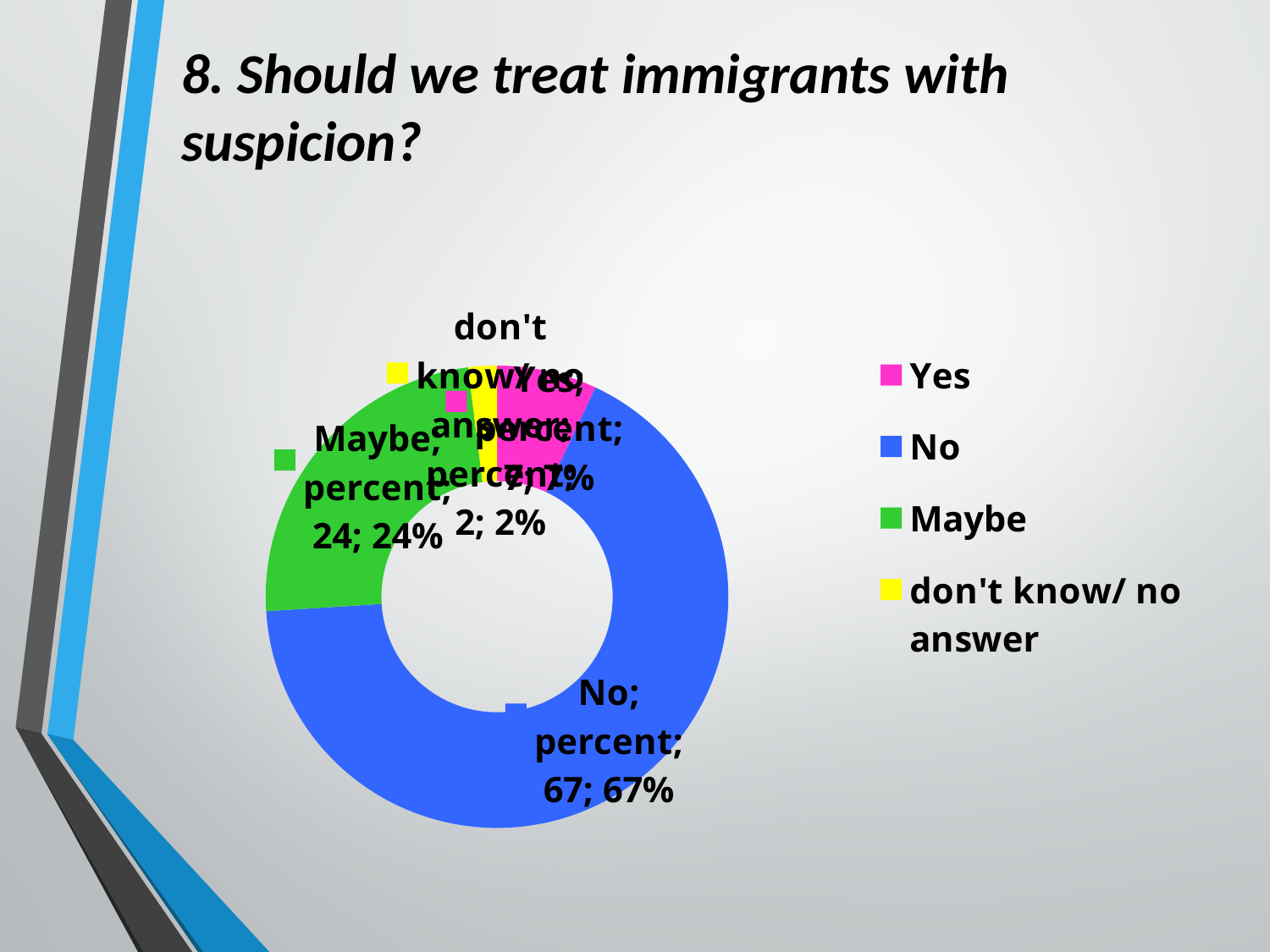
What percentage of respondents answered "Maybe"? 24% What kind of chart is shown on the slide? doughnut chart How many entries does the legend list? 4 What percentage of respondents answered "don't know/ no answer"? 2% What colour represents the "No" category in the chart? blue What is the title of the slide containing the chart? 8. Should we treat immigrants with suspicion? Which response category has the largest share of the chart? No What is the difference in percentage points between the "No" and "Maybe" shares? 43 How many response categories does the chart show? 4 Which response category has the smallest share of the chart? don't know/ no answer Which is larger, the share for "Maybe" or the share for "don't know/ no answer"? Maybe What percentage of respondents answered "No"? 67%